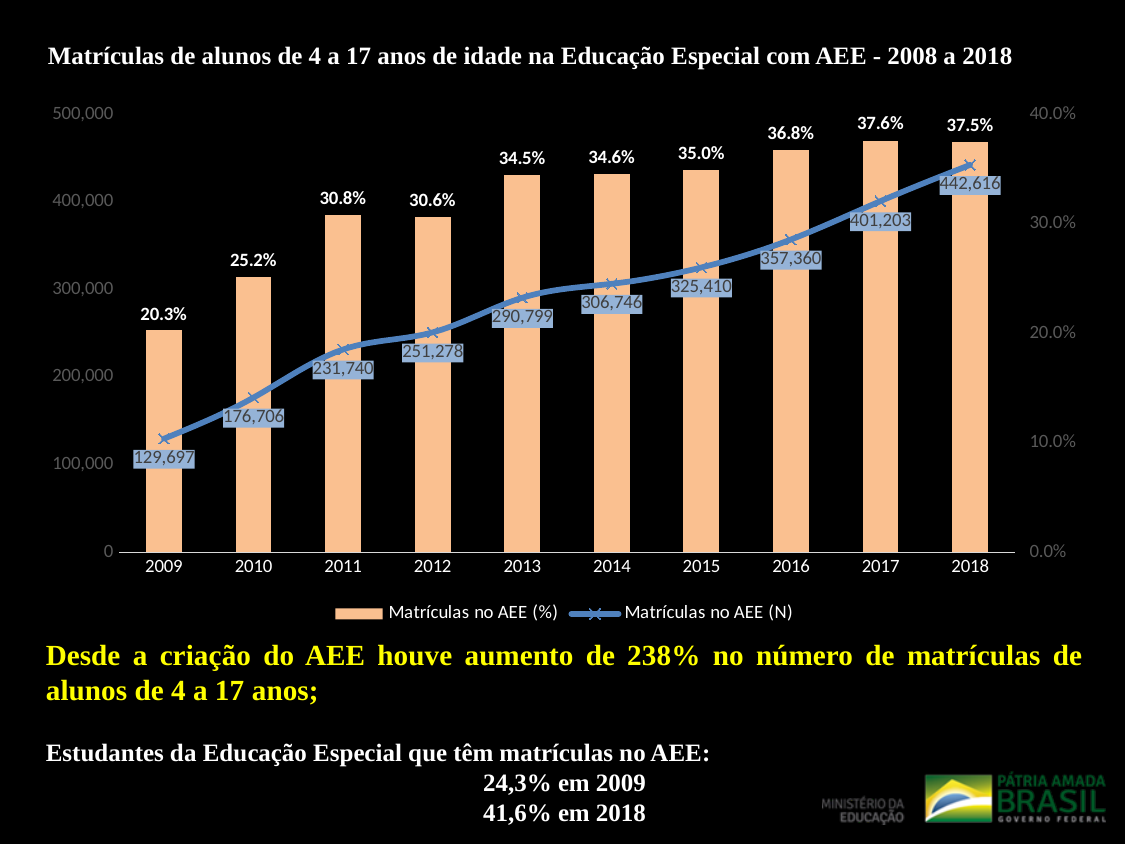
What is the value of Matrículas no AEE (%) for 2011? 30.8% Which year has the lowest value of Matrículas no AEE (%)? 2009 Which year has the highest value of Matrículas no AEE (N)? 2018 What is the value of Matrículas no AEE (N) for 2018? 442,616 What is the difference between Matrículas no AEE (N) in 2018 and in 2009? 312,919 What is the value of Matrículas no AEE (N) for 2013? 290,799 Does Matrículas no AEE (N) rise or fall from 2009 to 2018? Rise What is the value of Matrículas no AEE (%) for 2009? 20.3% How many series does the legend list? 2 How many years are shown on the x axis? 10 Which is larger: Matrículas no AEE (N) in 2016 or in 2014? 2016 What kind of chart is this? Combined bar and line chart